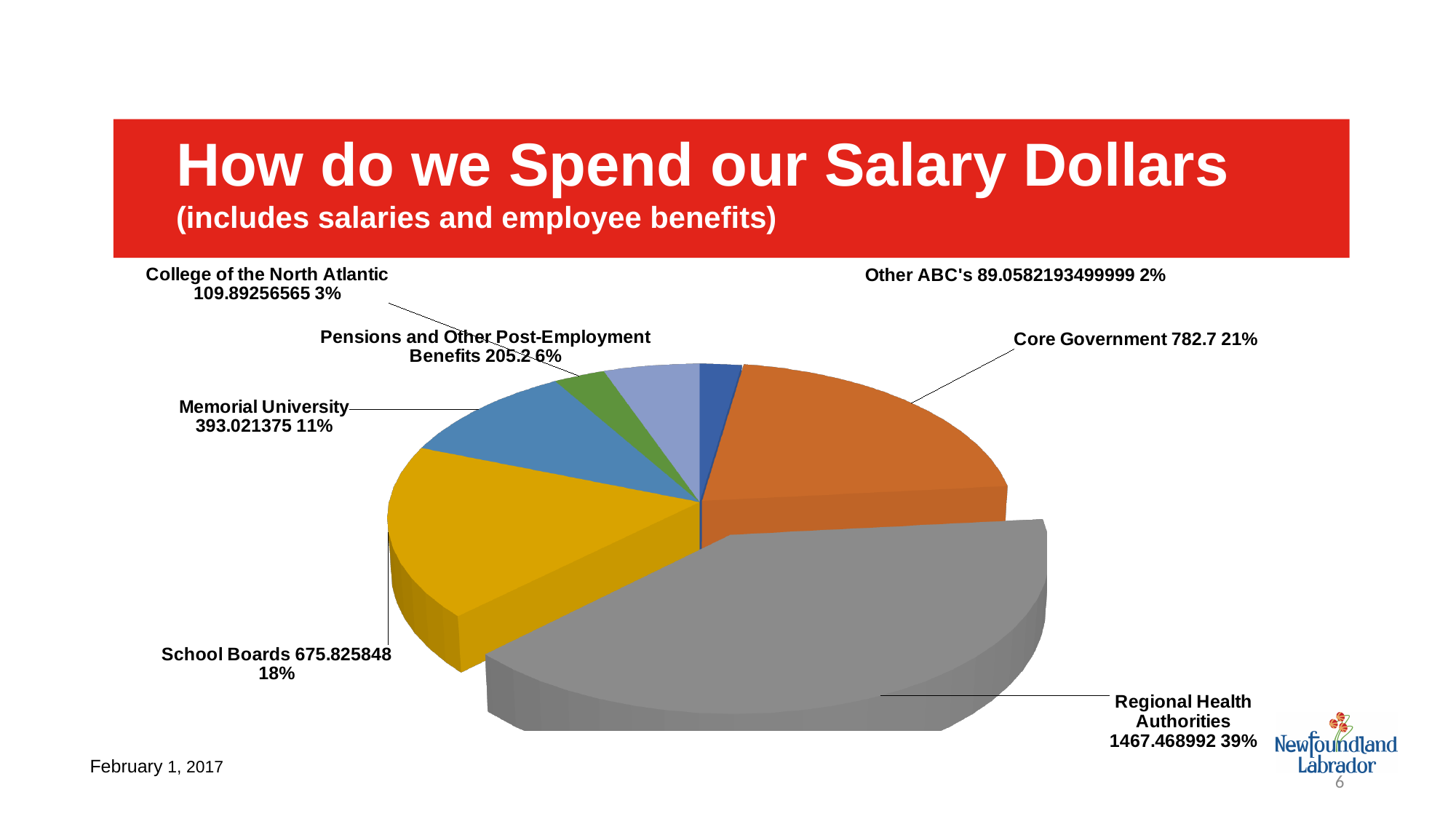
What is the value shown for Regional Health Authorities? 1467.468992 Which is larger, the value for Core Government or the value for School Boards? Core Government What is the title of the chart slide? How do we Spend our Salary Dollars What is the difference between the values for Regional Health Authorities and Core Government? 684.768992 What percentage share does School Boards have in the pie chart? 18% What is the value shown for Core Government? 782.7 Which category has the largest slice of the pie chart? Regional Health Authorities What is the value shown for Pensions and Other Post-Employment Benefits? 205.2 Which category has the smallest slice of the pie chart? Other ABC's What kind of chart is shown on the slide? Pie chart What percentage share does Memorial University have in the pie chart? 11% How many slices does the pie chart have? 7